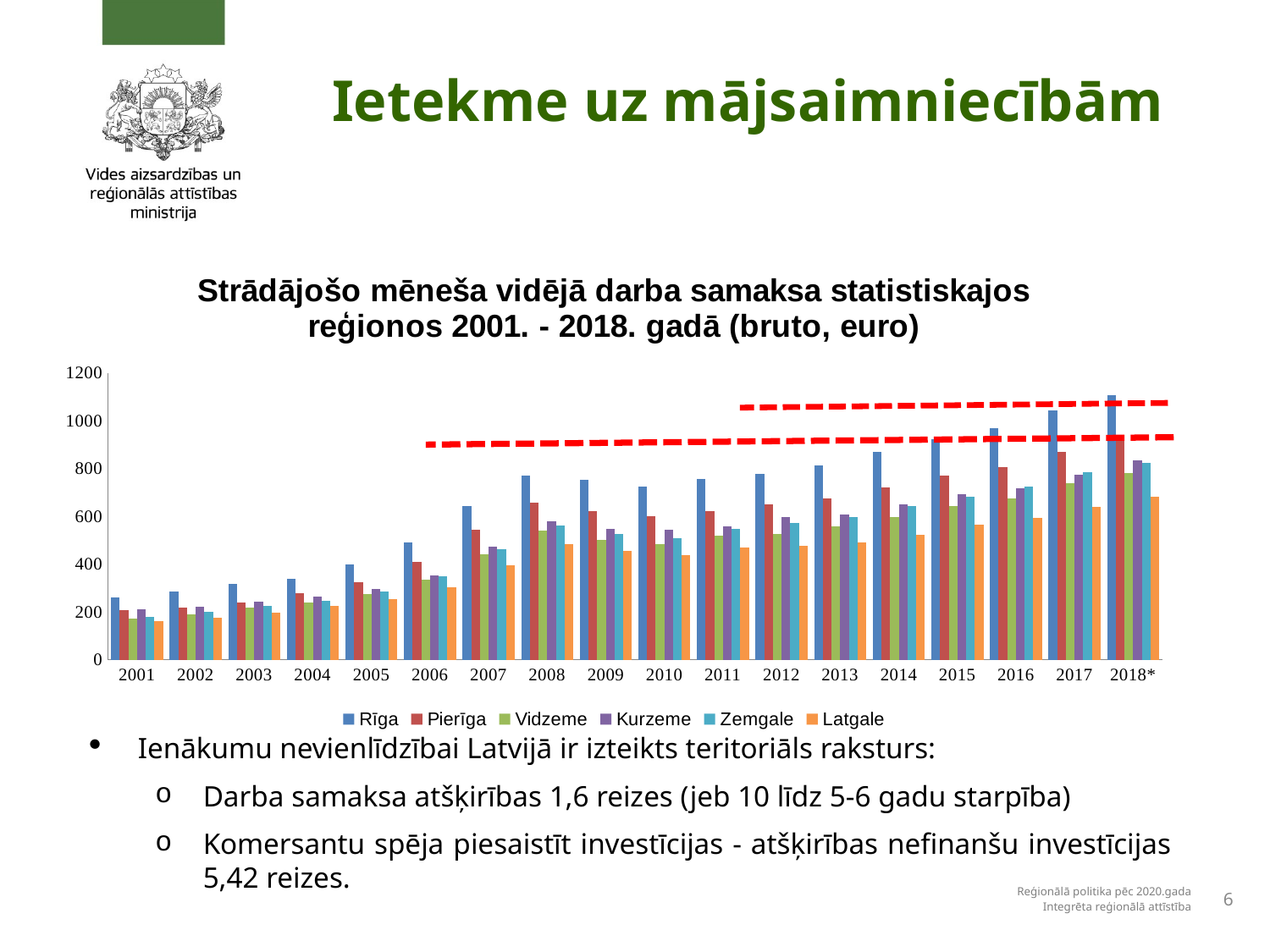
Which region has the highest average monthly wage in 2018*? Rīga Is the value for Pierīga in 2018* greater or less than 1000? less Which series is listed first in the legend? Rīga How many years are shown along the x axis? 18 Is the value for Latgale in 2001 greater or less than 200? less Which is larger in 2010, the value for Rīga or the value for Latgale? Rīga How many series does the legend list? 6 Which region has the lowest average monthly wage in 2018*? Latgale Do the values for Rīga generally rise or fall from 2001 to 2018*? rise Is the value for Rīga in 2018* greater or less than 1000? greater What kind of chart is shown on the slide? bar chart